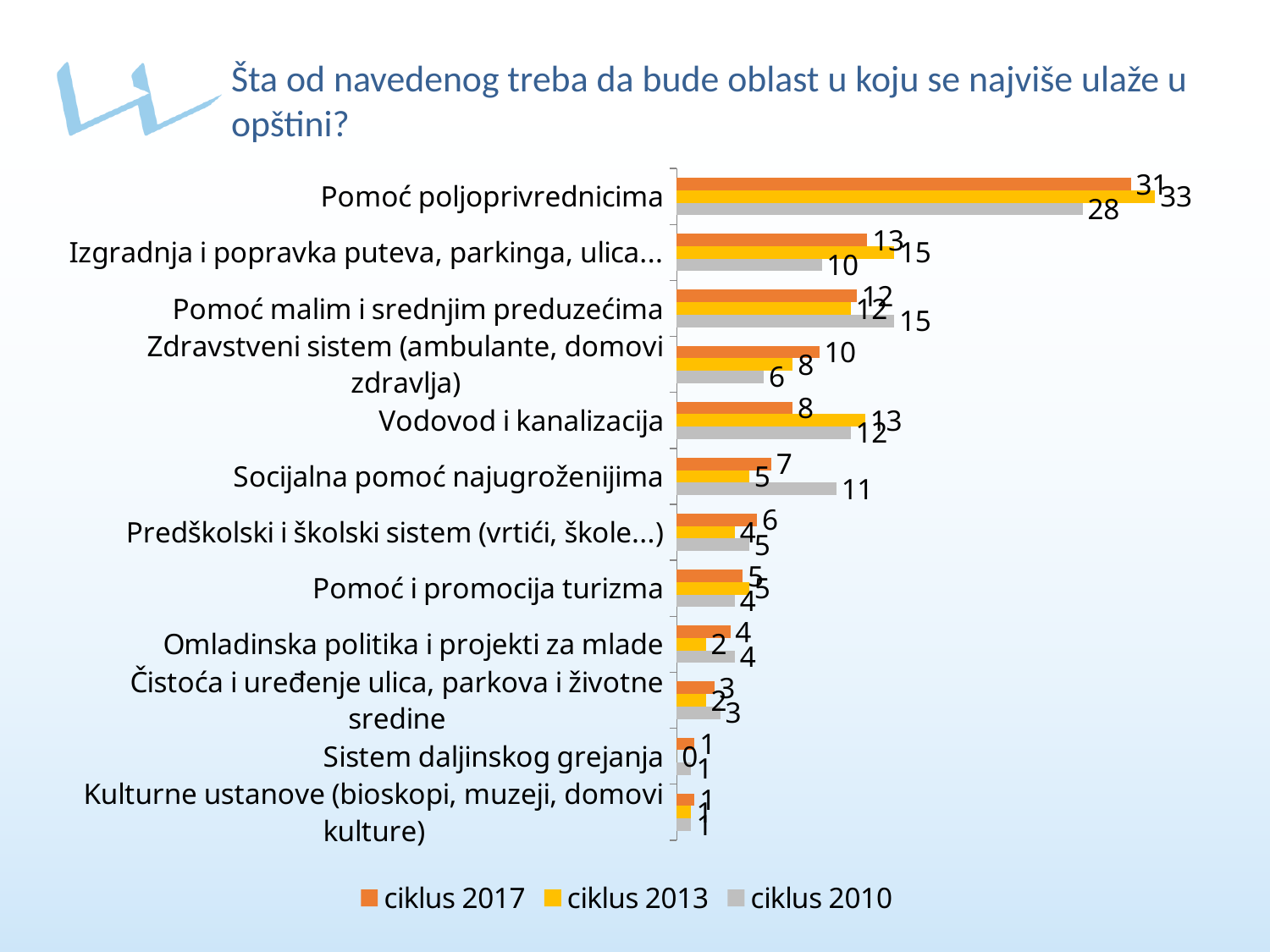
How many categories are shown on the chart? 12 Which category has the highest value in the ciklus 2017 series? Pomoć poljoprivrednicima What is the value for Pomoć poljoprivrednicima in the ciklus 2013 series? 33 What is the value for Socijalna pomoć najugroženijima in the ciklus 2010 series? 11 What is the value for Zdravstveni sistem (ambulante, domovi zdravlja) in the ciklus 2017 series? 10 What kind of chart is shown on the slide? Bar chart What is the difference between the ciklus 2013 and ciklus 2010 values for Pomoć poljoprivrednicima? 5 What is the value for Pomoć poljoprivrednicima in the ciklus 2010 series? 28 For Socijalna pomoć najugroženijima, which is larger: the ciklus 2017 value or the ciklus 2010 value? ciklus 2010 How many series does the legend list? 3 For Zdravstveni sistem (ambulante, domovi zdravlja), which is larger: the ciklus 2017 value or the ciklus 2010 value? ciklus 2017 What is the difference between the ciklus 2017 and ciklus 2010 values for Izgradnja i popravka puteva, parkinga, ulica...? 3